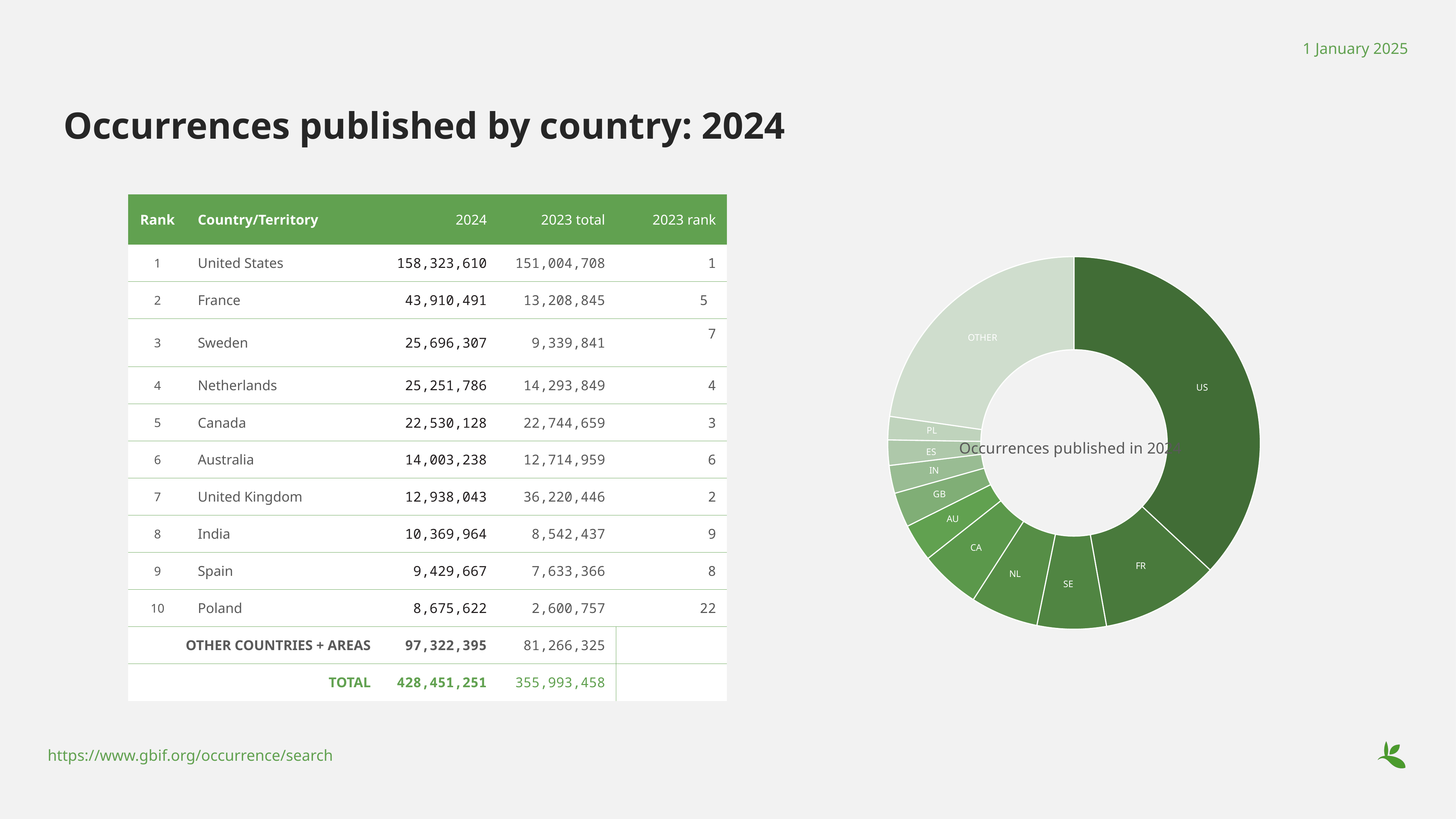
In the donut chart, which segment is larger, US or FR? US Which country segment of the donut chart is the smallest? PL Which segment of the donut chart is shaded the lightest green? OTHER What text is written in the centre of the donut chart? Occurrences published in 2024 In the donut chart, which segment is larger, CA or AU? CA How many segments does the donut chart have? 11 What kind of chart is shown on the right of the slide? donut chart What is the 2024 value for the US segment of the donut chart? 158,323,610 In the donut chart, which segment is larger, OTHER or FR? OTHER Which segment of the donut chart is the largest? US What is the 2024 value for the PL segment of the donut chart? 8,675,622 What is the difference between the 2024 values for the US and FR segments? 114,413,119